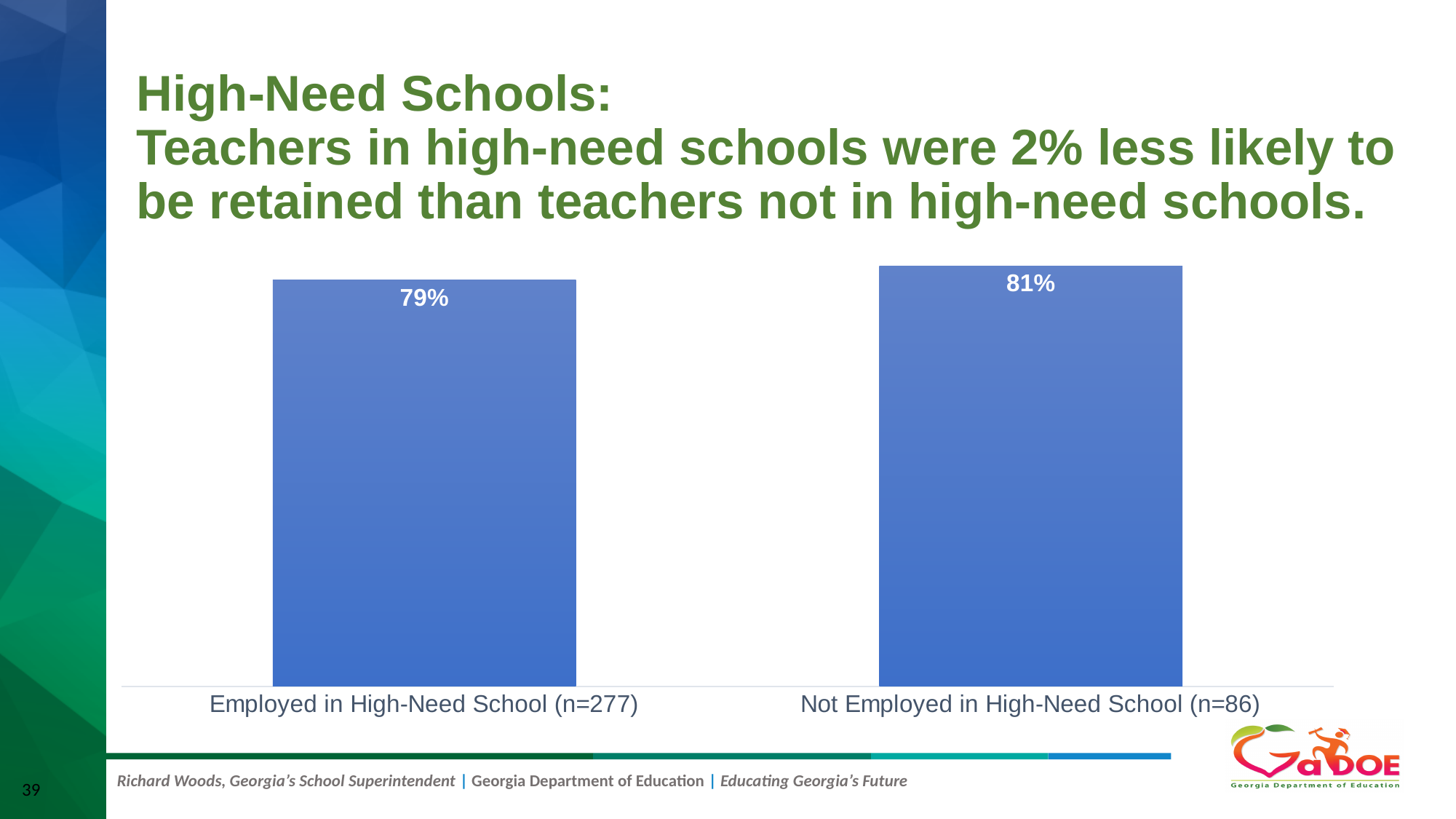
Which category has the lowest value? Employed in High-Need School (n=277) What is the value for Not Employed in High-Need School (n=86)? 81% What is the sample size (n) shown for the Employed in High-Need School category? 277 What is the sample size (n) shown for the Not Employed in High-Need School category? 86 Which is larger: the value for Employed in High-Need School or Not Employed in High-Need School? Not Employed in High-Need School What is the value for Employed in High-Need School (n=277)? 79% What is the difference between the values for Not Employed in High-Need School and Employed in High-Need School? 2% What kind of chart is shown on the slide? Bar chart Which category has the highest value? Not Employed in High-Need School (n=86) How many categories are shown in the chart? 2